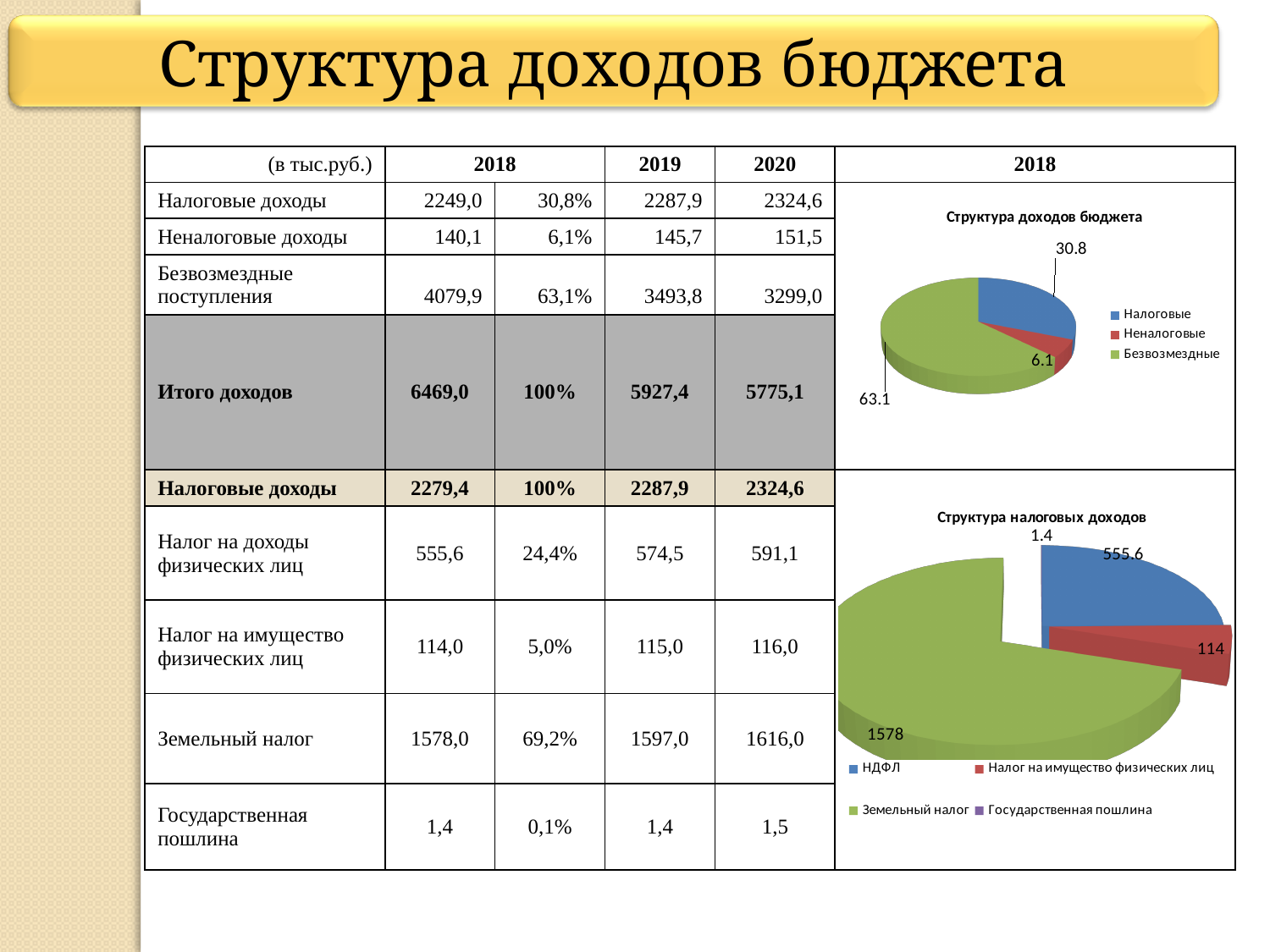
In the chart titled "Структура доходов бюджета", which category has the smallest slice? Неналоговые In the chart titled "Структура налоговых доходов", what value is shown for Земельный налог? 1578 In the chart titled "Структура доходов бюджета", how many categories does the legend list? 3 In the chart titled "Структура доходов бюджета", which category has the largest slice? Безвозмездные In the chart titled "Структура налоговых доходов", how many categories does the legend list? 4 In the chart titled "Структура доходов бюджета", what value is shown for Налоговые? 30.8 In the chart titled "Структура доходов бюджета", what is the difference between the values for Безвозмездные and Налоговые? 32.3 What type of chart is the chart titled "Структура доходов бюджета"? pie chart In the chart titled "Структура налоговых доходов", which is larger: НДФЛ or Налог на имущество физических лиц? НДФЛ In the chart titled "Структура налоговых доходов", what value is shown for НДФЛ? 555.6 In the chart titled "Структура доходов бюджета", what value is shown for Неналоговые? 6.1 In the chart titled "Структура налоговых доходов", which category has the smallest value? Государственная пошлина